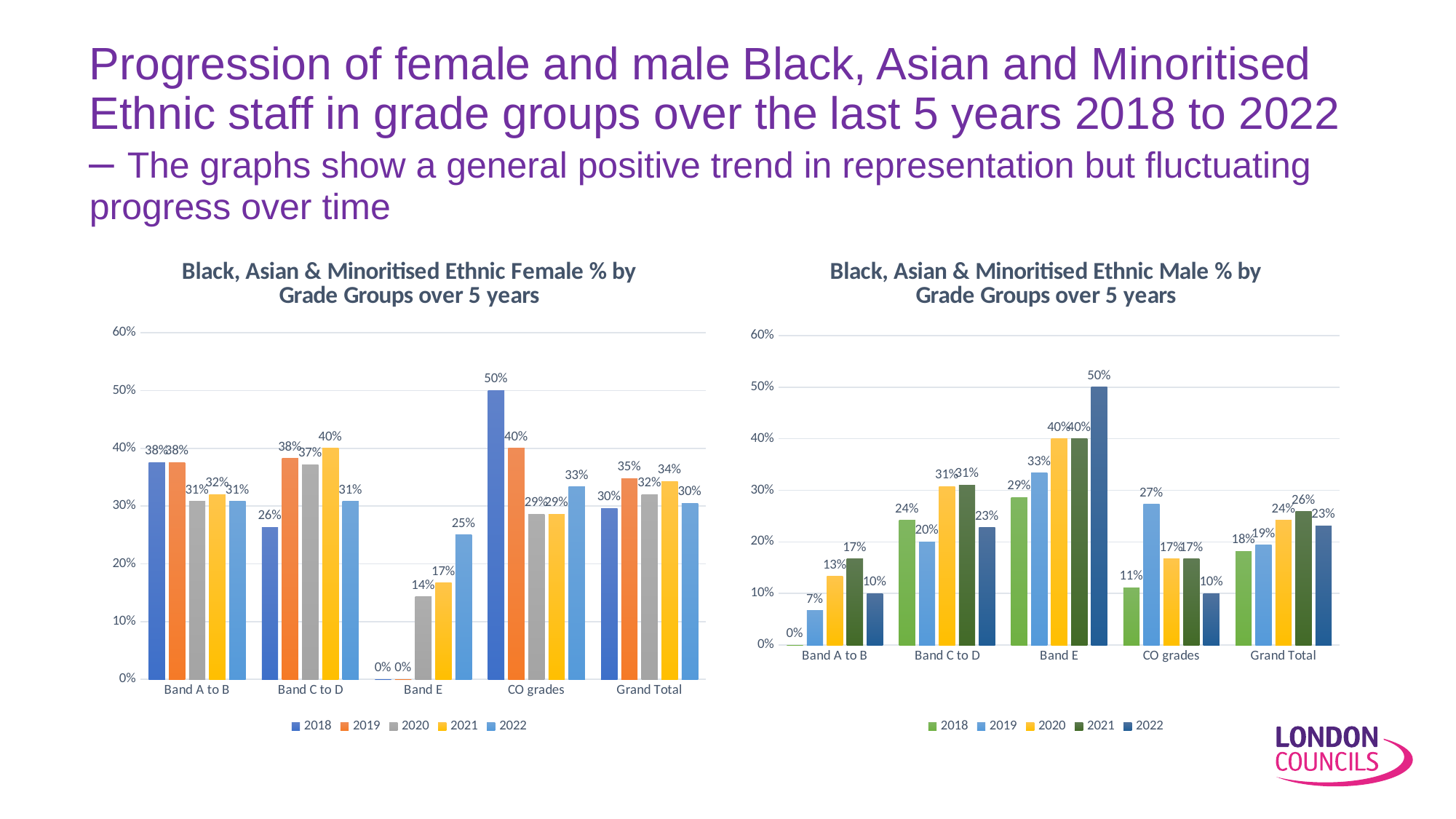
In the Black, Asian & Minoritised Ethnic Female % chart, what is the difference between the 2018 and 2019 values for Band C to D? 12% In the Black, Asian & Minoritised Ethnic Male % chart, what is the difference between the 2019 and 2022 values for CO grades? 17% In the Black, Asian & Minoritised Ethnic Female % chart, which is larger for Grand Total: the 2019 value or the 2021 value? 2019 In the Black, Asian & Minoritised Ethnic Female % chart, what is the value for Band E in 2022? 25% How many series does the legend of the Black, Asian & Minoritised Ethnic Male % chart list? 5 In the Black, Asian & Minoritised Ethnic Male % chart, what is the Grand Total value for 2021? 26% In the Black, Asian & Minoritised Ethnic Female % chart, which year has the highest value for Band C to D? 2021 In the Black, Asian & Minoritised Ethnic Male % chart, what is the value for Band E in 2022? 50% In the Black, Asian & Minoritised Ethnic Male % chart, do the Band E values rise or fall from 2018 to 2022? rise In the Black, Asian & Minoritised Ethnic Male % chart, which year has the lowest value for Band A to B? 2018 What kind of chart is the Black, Asian & Minoritised Ethnic Female % by Grade Groups chart? bar chart In the Black, Asian & Minoritised Ethnic Female % chart, what is the value for CO grades in 2018? 50%